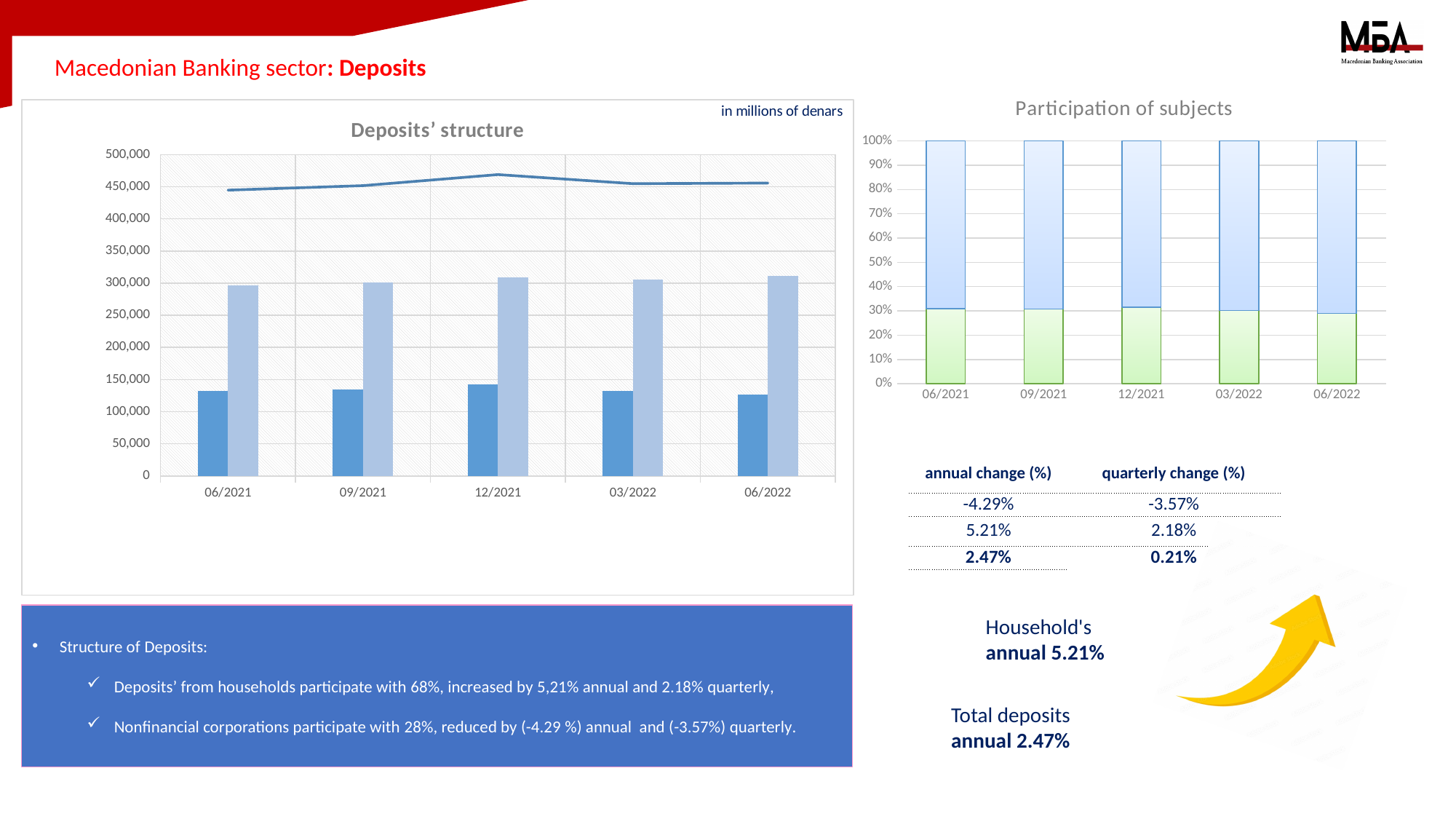
In the 'Deposits' structure' chart, is the light blue bar for 12/2021 greater or less than 300,000? greater In the 'Deposits' structure' chart, is the dark blue bar for 06/2021 greater or less than 150,000? less In the 'Deposits' structure' chart, in which period does the line reach its highest value? 12/2021 In the 'Deposits' structure' chart, in which period is the dark blue bar lowest? 06/2022 In the 'Deposits' structure' chart, is the value of the line at 12/2021 greater or less than 450,000? greater How many periods are shown on the x axis of the 'Deposits' structure' chart? 5 In the 'Deposits' structure' chart, which is larger at 06/2022: the dark blue bar or the light blue bar? the light blue bar What kind of chart is the 'Deposits' structure' chart? bar chart with a line What unit is stated for the 'Deposits' structure' chart? in millions of denars How many periods are shown on the x axis of the 'Participation of subjects' chart? 5 What kind of chart is the 'Participation of subjects' chart? stacked bar chart